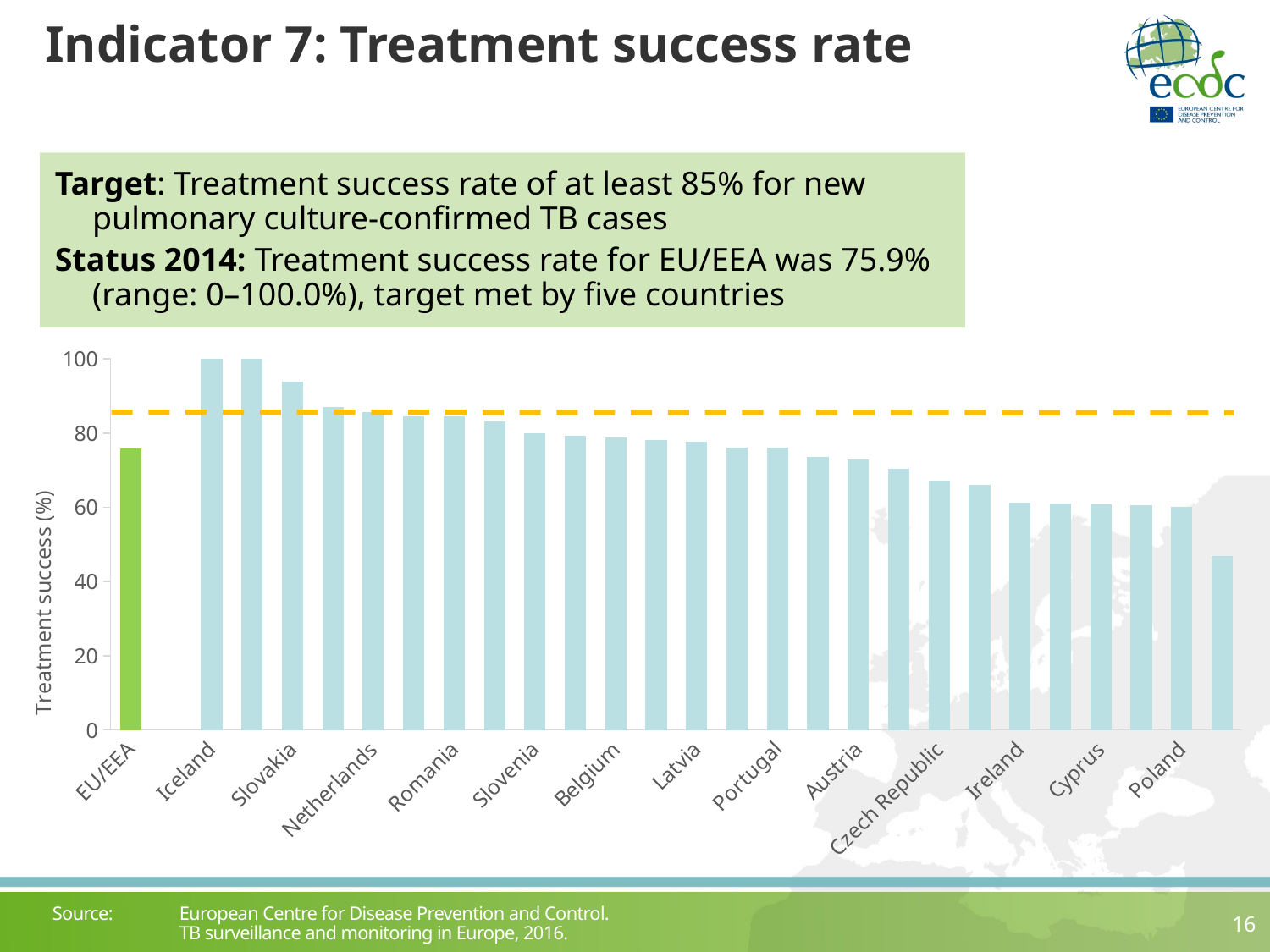
Is the value for Poland greater or less than 80? less Is the value for Slovakia greater or less than 80? greater Which has a higher treatment success rate, Iceland or Poland? Iceland What kind of chart is shown on the slide? bar chart What is the treatment success rate for EU/EEA shown on the slide? 75.9% Which has a higher treatment success rate, Slovakia or Austria? Slovakia Do the country values rise or fall from left to right across the chart? fall What is the label of the vertical axis? Treatment success (%) Is the value for Czech Republic greater or less than 60? greater What is the treatment success value for Iceland? 100